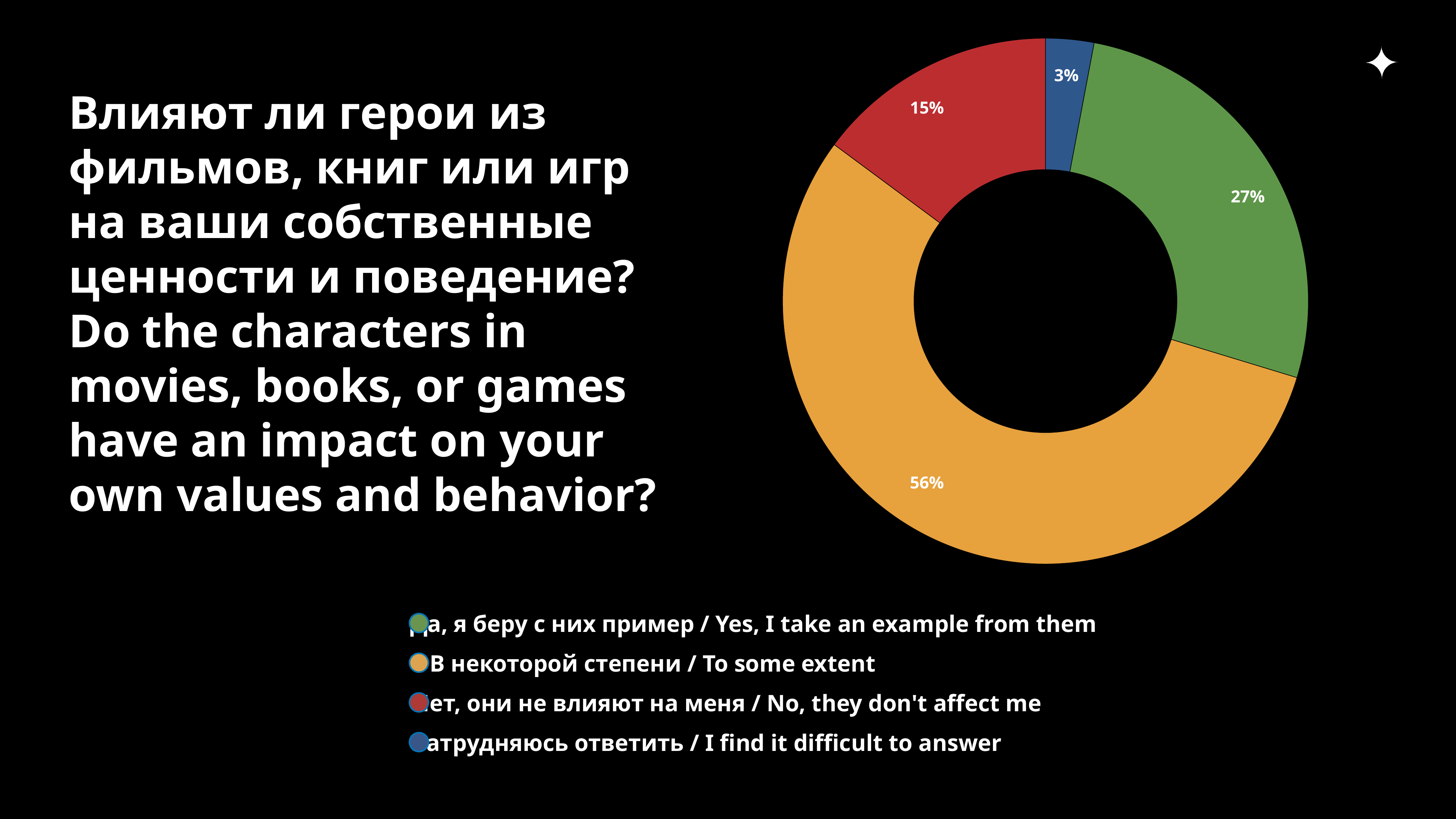
Which answer option has the smallest share of the chart? I find it difficult to answer Which answer option has the largest share of the chart? To some extent What is the difference in percentage points between "No, they don't affect me" and "I find it difficult to answer"? 12 What percentage of respondents answered "I find it difficult to answer"? 3% What colour is the slice for "No, they don't affect me"? red What is the difference in percentage points between "To some extent" and "Yes, I take an example from them"? 29 What percentage of respondents answered "To some extent"? 56% What percentage of respondents answered "No, they don't affect me"? 15% How many answer options (slices) does the chart show? 4 What percentage of respondents answered "Yes, I take an example from them"? 27% Which is larger: the share for "Yes, I take an example from them" or the share for "No, they don't affect me"? Yes, I take an example from them What kind of chart is shown on the slide? doughnut chart